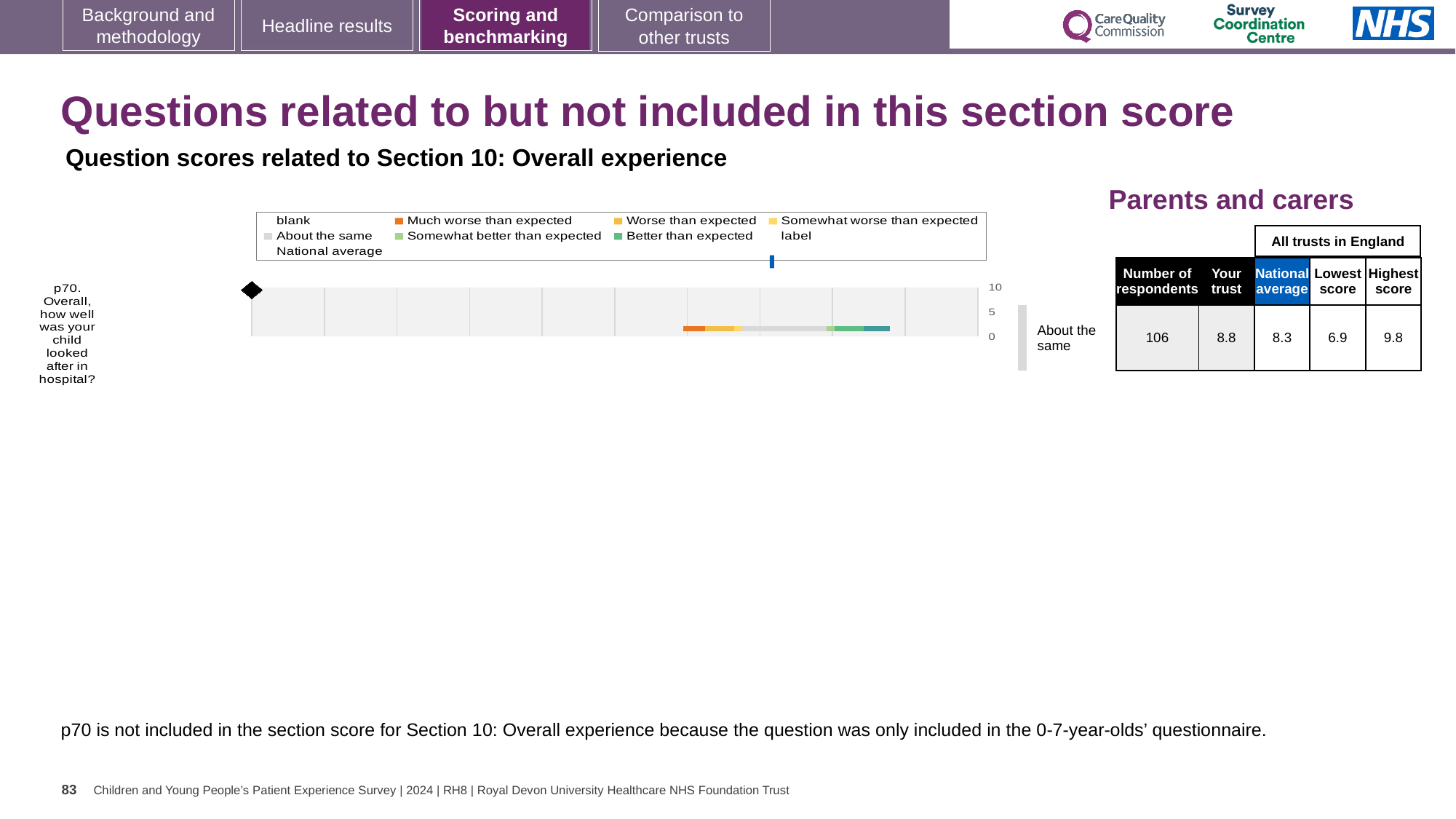
What is the highest value shown on the chart's axis? 10 How many questions are plotted in the chart? 1 What category label is shown to the right of the p70 bar? About the same In the Parents and carers table, what is the 'Your trust' score for p70? 8.8 For p70, which is larger: the 'Your trust' score or the national average? Your trust In the Parents and carers table, what is the number of respondents for p70? 106 Which question is plotted in the chart? p70. Overall, how well was your child looked after in hospital? In the Parents and carers table, what is the lowest score among all trusts in England for p70? 6.9 In the Parents and carers table, what is the highest score among all trusts in England for p70? 9.8 For p70, what is the difference between the highest score and the lowest score among all trusts in England? 2.9 In the Parents and carers table, what is the national average score for p70? 8.3 What kind of chart is used to show the p70 question score? Bar chart